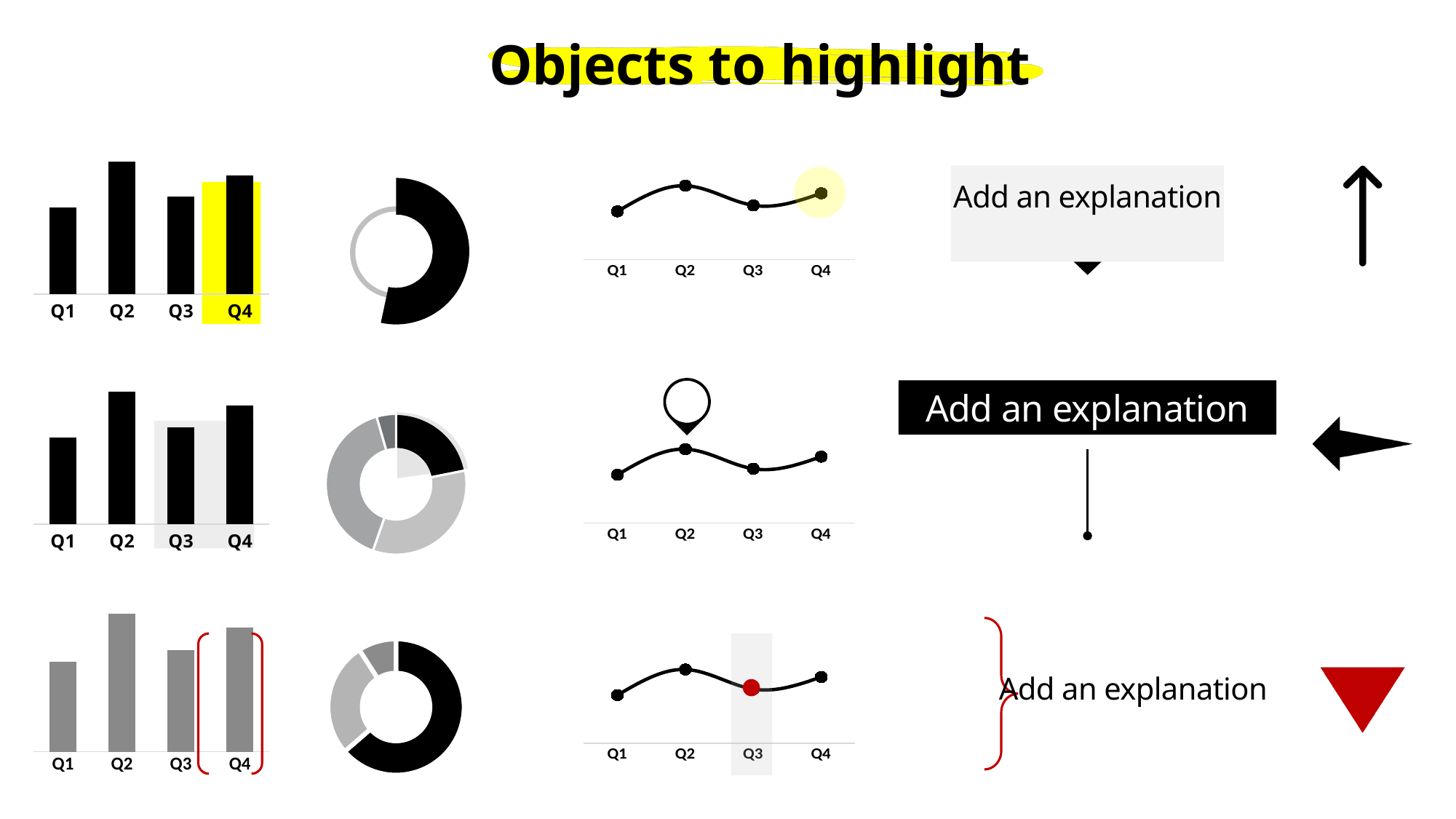
How many categories are shown on the x axis of the top-left bar chart? 4 In the middle-left bar chart, is the bar for Q4 taller or shorter than the bar for Q3? Taller In the bottom line chart (third column), which quarter's point is marked in red? Q3 What kind of chart is the chart in the top-left corner of the slide? Bar chart What kind of chart is the chart in the top row, second column of the slide? Donut chart In the bottom-left bar chart, is the bar for Q3 taller or shorter than the bar for Q1? Taller In the top-left bar chart, which quarter has the highest bar? Q2 In the middle line chart (third column), which quarter has the lowest point? Q1 In the bottom-left bar chart, which quarter has the tallest bar? Q2 In the top-left bar chart, which quarter is highlighted in yellow? Q4 In the top-left bar chart, which quarter has the lowest bar? Q1 In the top line chart (third column), which quarter has the highest point? Q2